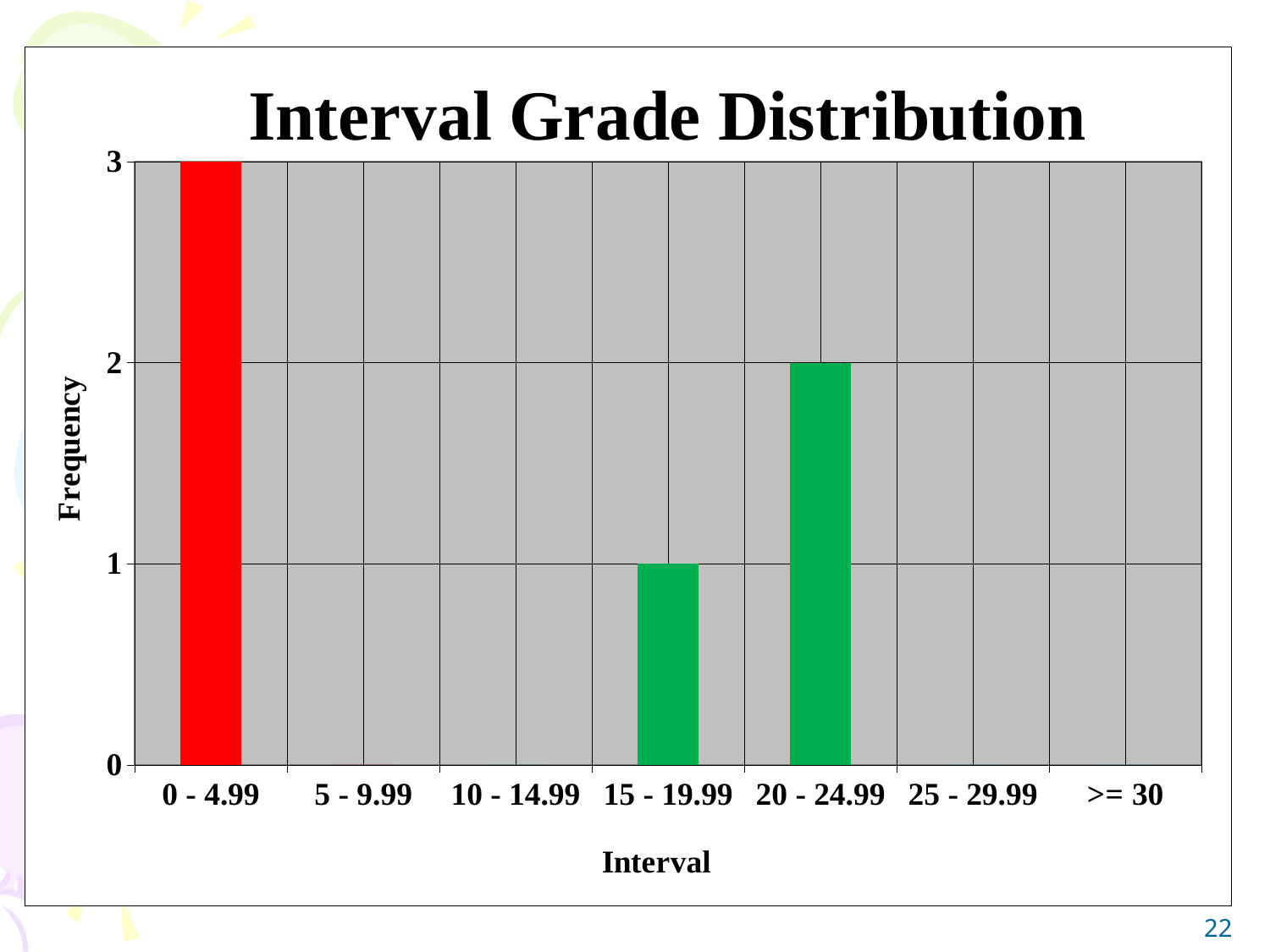
Is the frequency for the 0 - 4.99 interval greater or less than 2? greater How many intervals are shown on the x axis? 7 What is the frequency for the 5 - 9.99 interval? 0 What is the frequency for the 20 - 24.99 interval? 2 What is the difference in frequency between the 0 - 4.99 interval and the 20 - 24.99 interval? 1 What is the title of the chart? Interval Grade Distribution What is the frequency for the 15 - 19.99 interval? 1 Which has a higher frequency, the 15 - 19.99 interval or the 20 - 24.99 interval? 20 - 24.99 Which interval has the highest frequency? 0 - 4.99 What is the frequency for the 0 - 4.99 interval? 3 What is the label of the y axis? Frequency What kind of chart is shown on the slide? bar chart